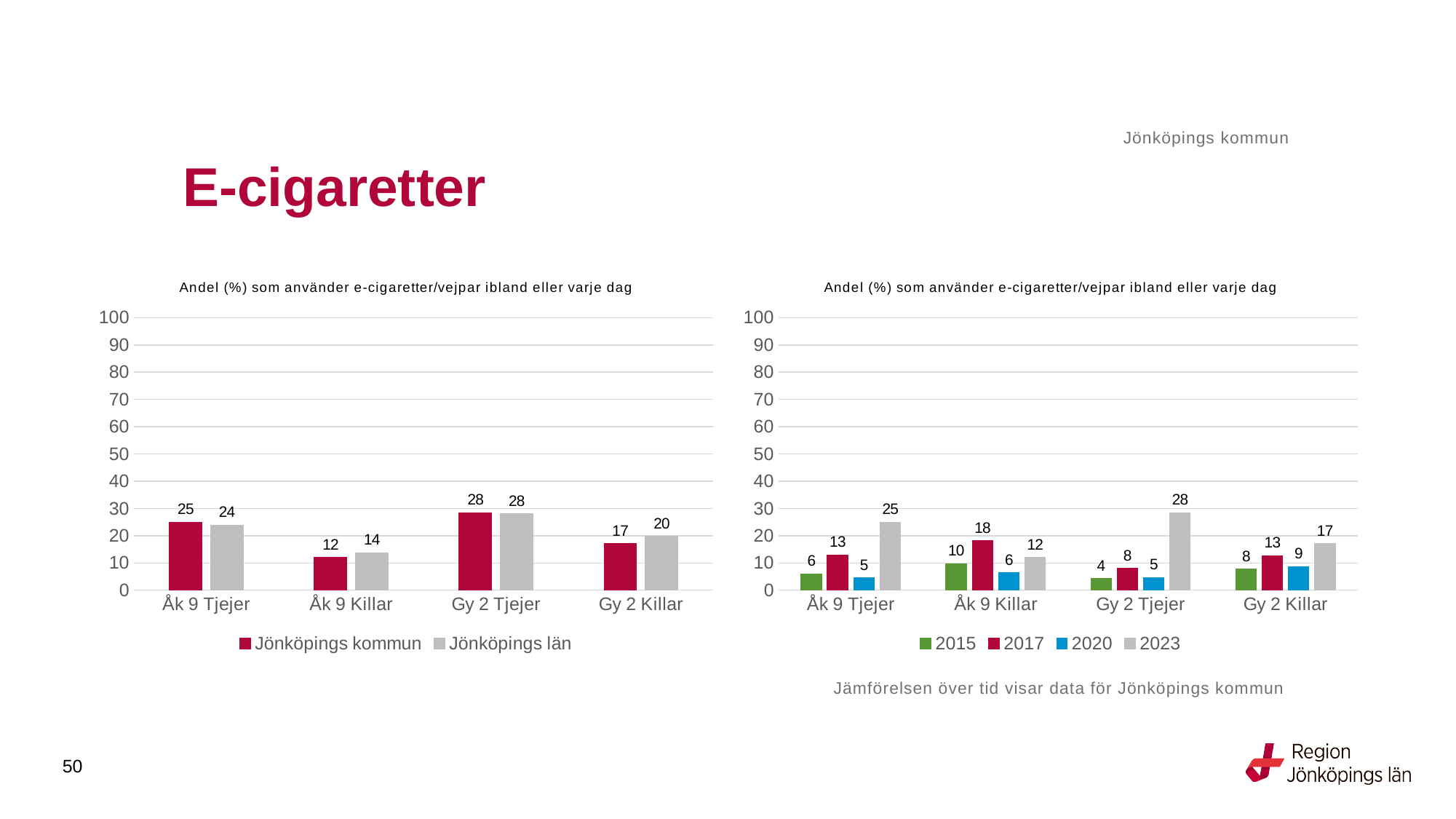
In the left chart, what is the value for Jönköpings län for Gy 2 Killar? 20 In the right chart, which category has the highest value for 2017? Åk 9 Killar In the left chart, what is the difference between Jönköpings län and Jönköpings kommun for Gy 2 Killar? 3 In the left chart, which category has the lowest value for Jönköpings kommun? Åk 9 Killar In the right chart, is the 2023 value for Åk 9 Tjejer larger than the 2020 value for Åk 9 Tjejer? Yes In the left chart, how many series does the legend list? 2 In the right chart, how many series does the legend list? 4 In the right chart, what is the difference between the 2023 and 2020 values for Gy 2 Tjejer? 23 In the right chart, what is the value for 2023 for Gy 2 Tjejer? 28 In the right chart, what is the value for 2015 for Åk 9 Killar? 10 What kind of chart is the right chart? Bar chart In the left chart, what is the value for Jönköpings kommun for Åk 9 Tjejer? 25